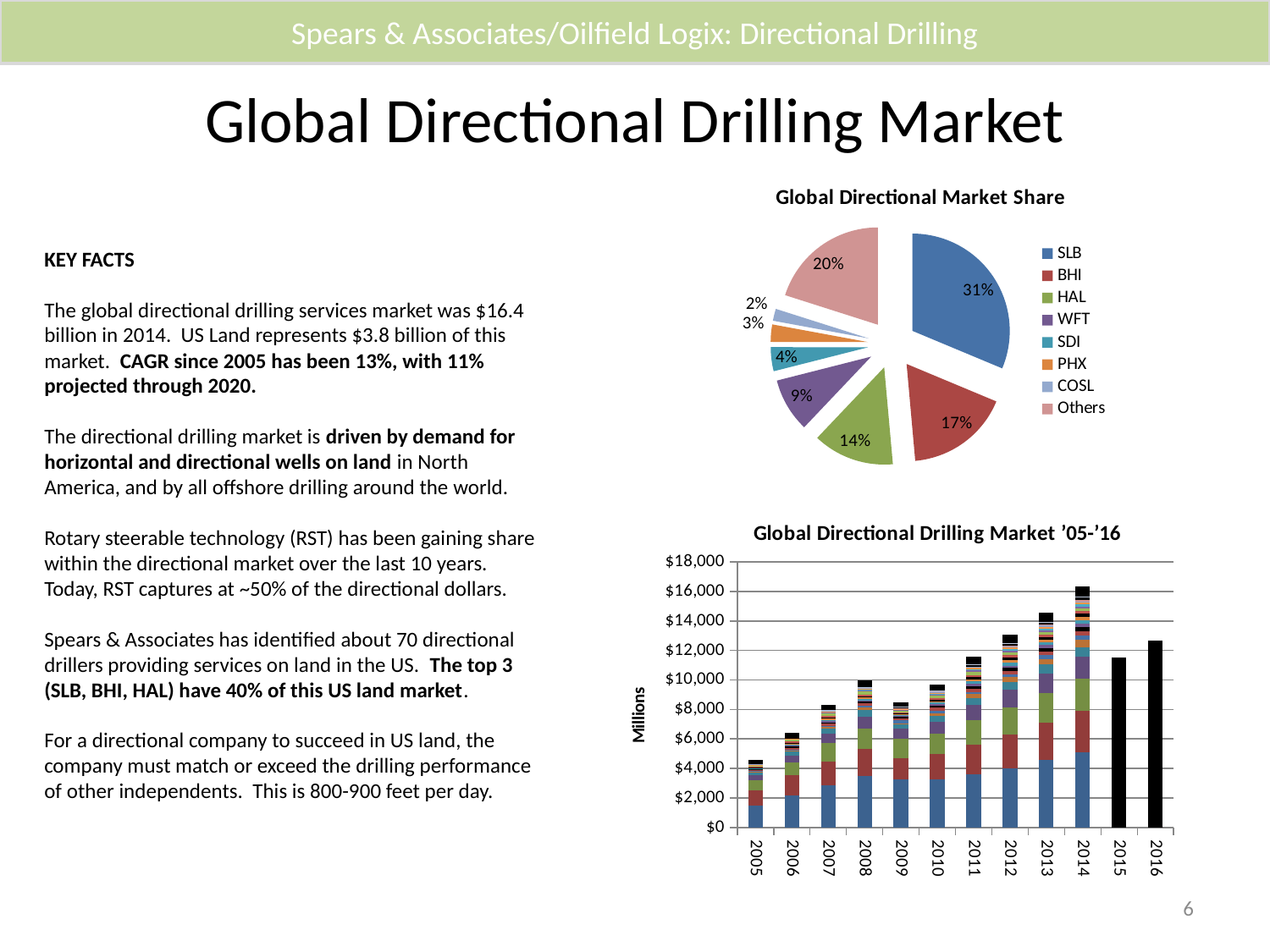
In the Global Directional Market Share pie chart, which company has the smallest share? COSL What kind of chart is the Global Directional Market Share chart? Pie chart In the Global Directional Drilling Market '05-'16 chart, how many years are shown on the x axis? 12 In the Global Directional Market Share pie chart, what share does WFT hold? 9% In the Global Directional Market Share pie chart, which named company has the largest share? SLB What kind of chart is the Global Directional Drilling Market '05-'16 chart? Stacked bar chart In the Global Directional Market Share pie chart, what share does SLB hold? 31% In the Global Directional Market Share pie chart, what share does BHI hold? 17% In the Global Directional Market Share pie chart, how many entries does the legend list? 8 In the Global Directional Market Share pie chart, how many percentage points larger is SLB's share than HAL's? 17 In the Global Directional Drilling Market '05-'16 chart, is the total for 2016 greater or less than $12,000? greater In the Global Directional Drilling Market '05-'16 chart, which year has a larger total, 2014 or 2015? 2014